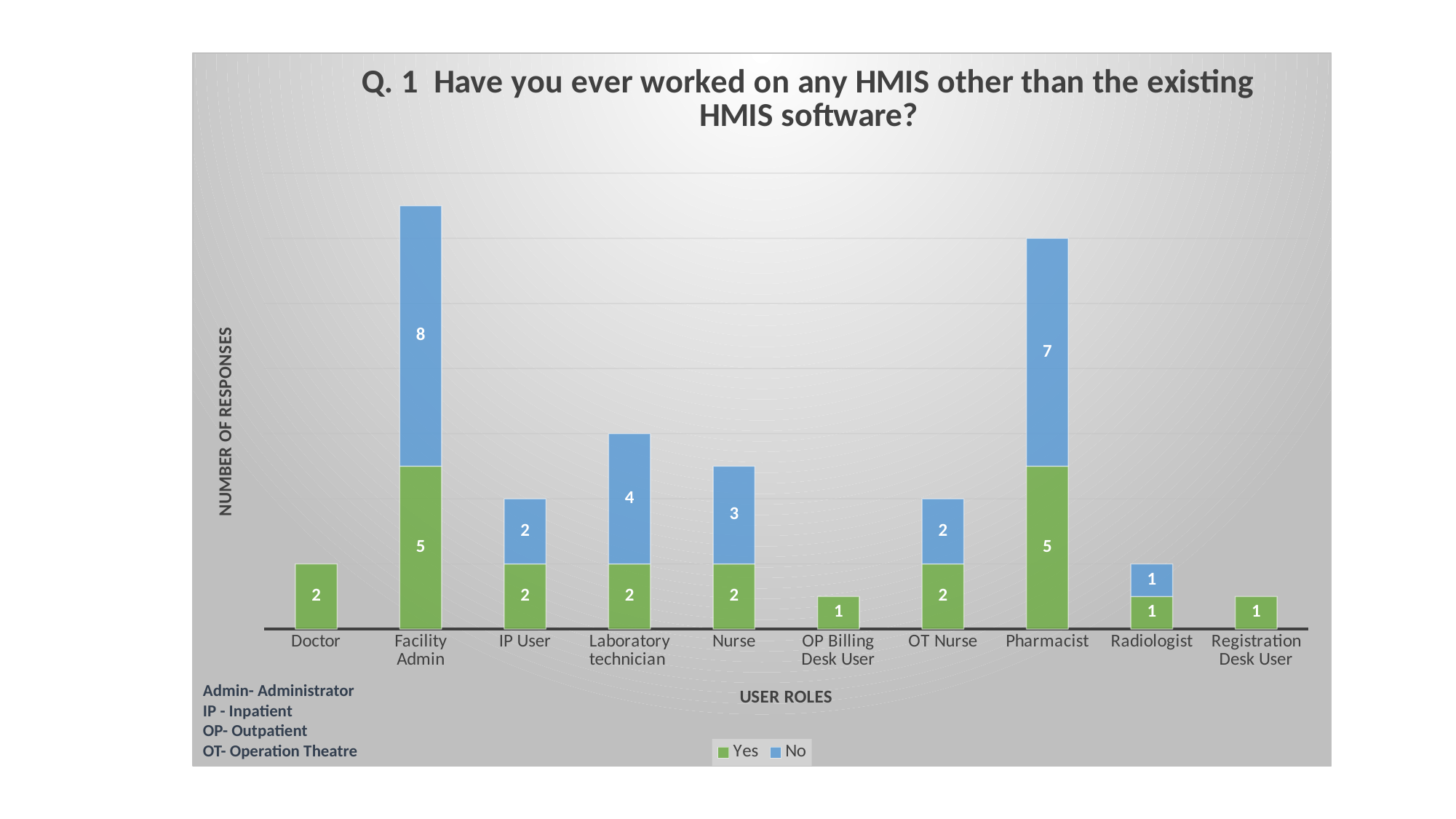
Which user role has the highest 'No' value? Facility Admin What is the total number of responses for Facility Admin? 13 What is the total number of responses for Pharmacist? 12 How many series does the legend list? 2 Which is larger, the 'No' value for Nurse or the 'No' value for IP User? Nurse What kind of chart is shown on the slide? Stacked bar chart How many user roles are shown on the x axis? 10 What is the label of the y axis? NUMBER OF RESPONSES What is the 'Yes' value for Pharmacist? 5 What is the 'No' value for Laboratory technician? 4 What is the 'No' value for Facility Admin? 8 What is the difference between the 'No' values for Facility Admin and Pharmacist? 1